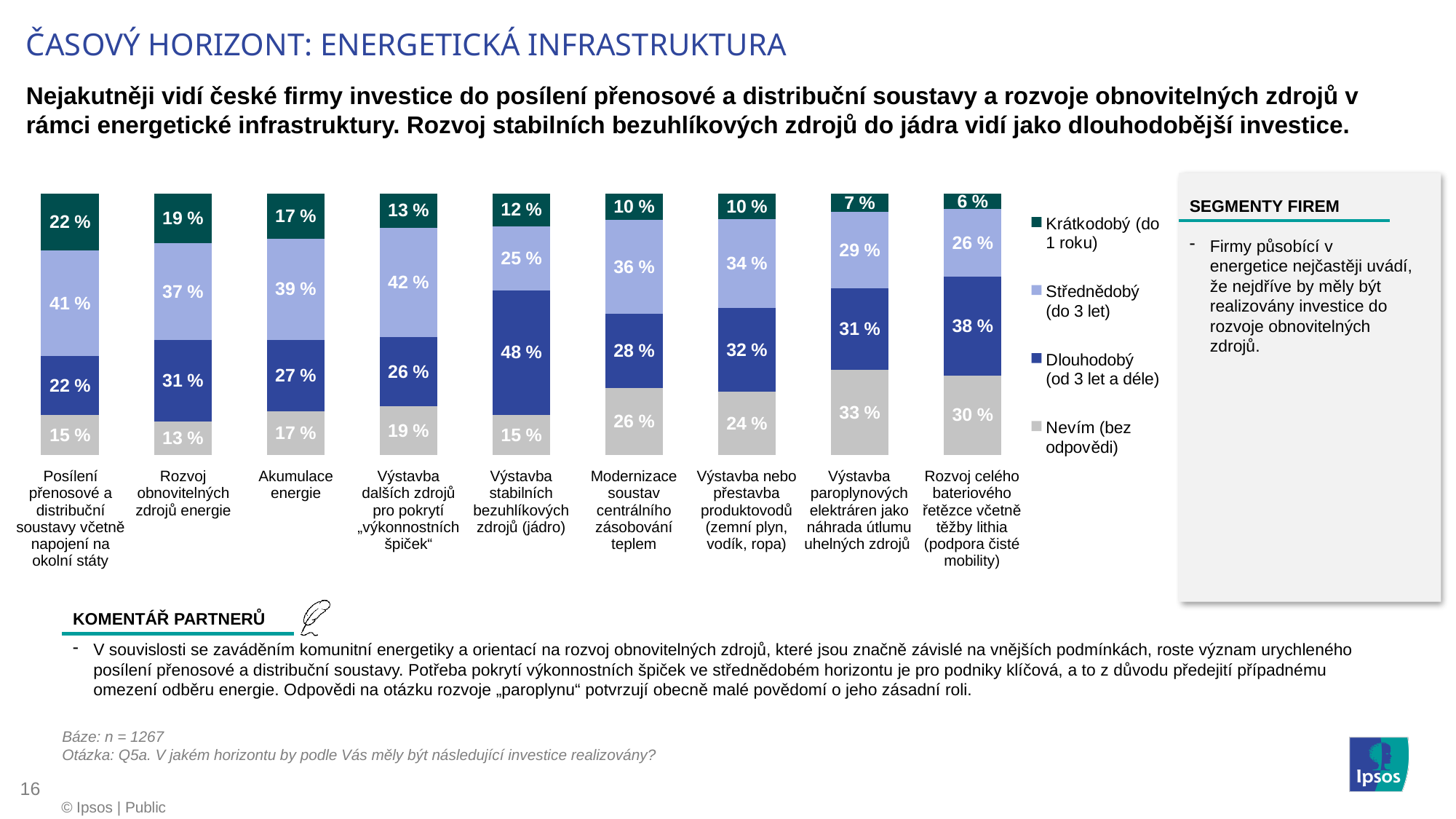
Which category has the lowest Krátkodobý (do 1 roku) value? Rozvoj celého bateriového řetězce včetně těžby lithia (podpora čisté mobility) How many series does the legend list? 4 Do the Krátkodobý (do 1 roku) values rise or fall from left to right across the categories? Fall How many categories are shown on the x axis of the chart? 9 What kind of chart is shown on the slide? Stacked bar chart What is the Střednědobý (do 3 let) value for Výstavba dalších zdrojů pro pokrytí „výkonnostních špiček“? 42 % What is the Krátkodobý (do 1 roku) value for Akumulace energie? 17 % What is the difference between the Dlouhodobý (od 3 let a déle) values for Výstavba stabilních bezuhlíkových zdrojů (jádro) and Posílení přenosové a distribuční soustavy? 26 % What is the Dlouhodobý (od 3 let a déle) value for Výstavba stabilních bezuhlíkových zdrojů (jádro)? 48 % Which category has the highest Krátkodobý (do 1 roku) value? Posílení přenosové a distribuční soustavy včetně napojení na okolní státy Which is larger: the Střednědobý (do 3 let) value for Rozvoj obnovitelných zdrojů energie or for Modernizace soustav centrálního zásobování teplem? Rozvoj obnovitelných zdrojů energie What is the Nevím (bez odpovědi) value for Výstavba paroplynových elektráren jako náhrada útlumu uhelných zdrojů? 33 %